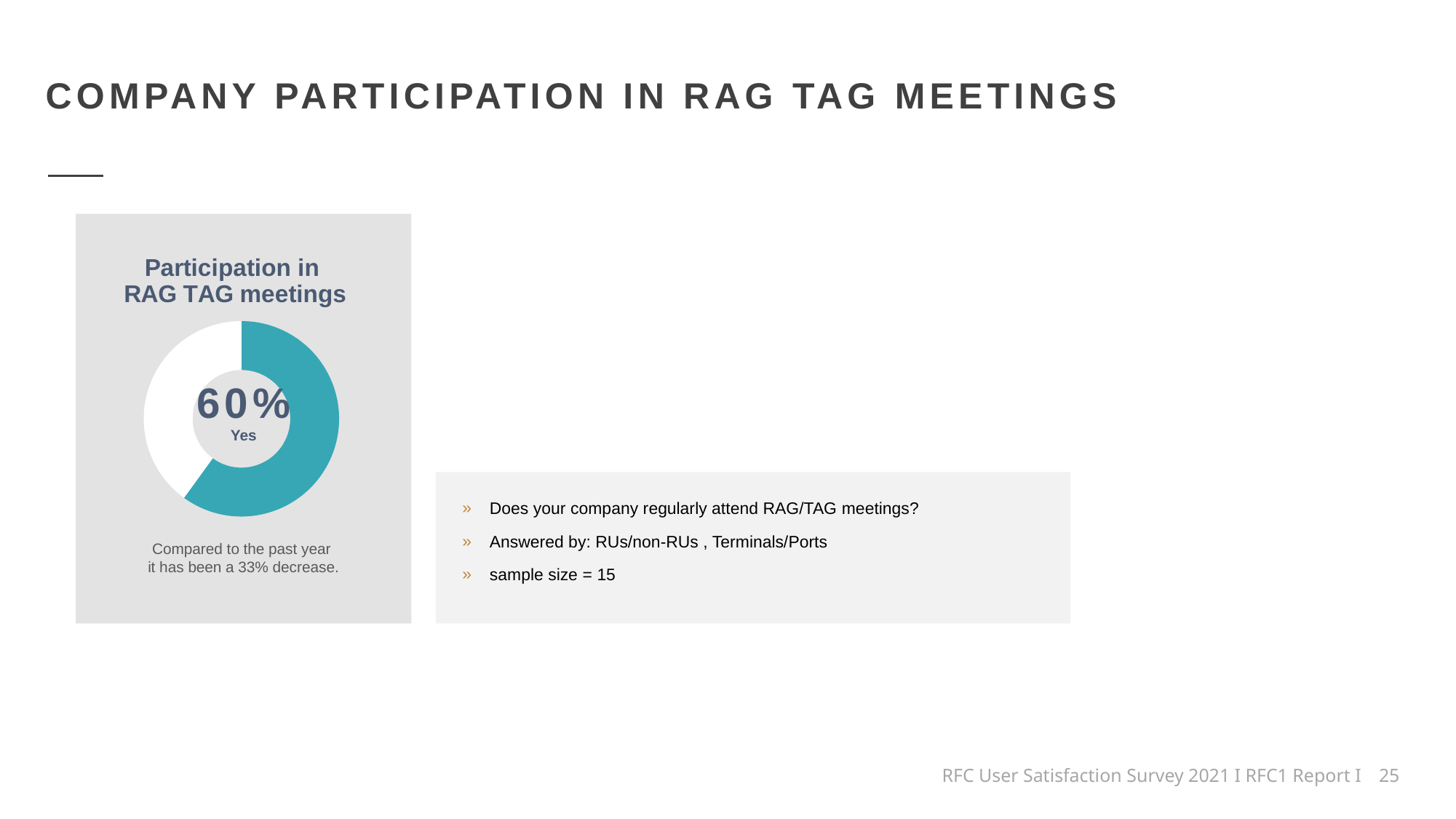
According to the note under the chart, how has participation changed compared to the past year? a 33% decrease Is the Yes share in the Participation in RAG TAG meetings chart greater or less than 50%? greater How many slices does the Participation in RAG TAG meetings chart have? 2 Which slice is the largest in the Participation in RAG TAG meetings chart? Yes What is the title of the chart on the slide? Participation in RAG TAG meetings In the Participation in RAG TAG meetings chart, which is larger: the Yes slice or the remaining slice? Yes What percentage of respondents answered Yes in the Participation in RAG TAG meetings chart? 60% What kind of chart is shown on the slide? doughnut chart